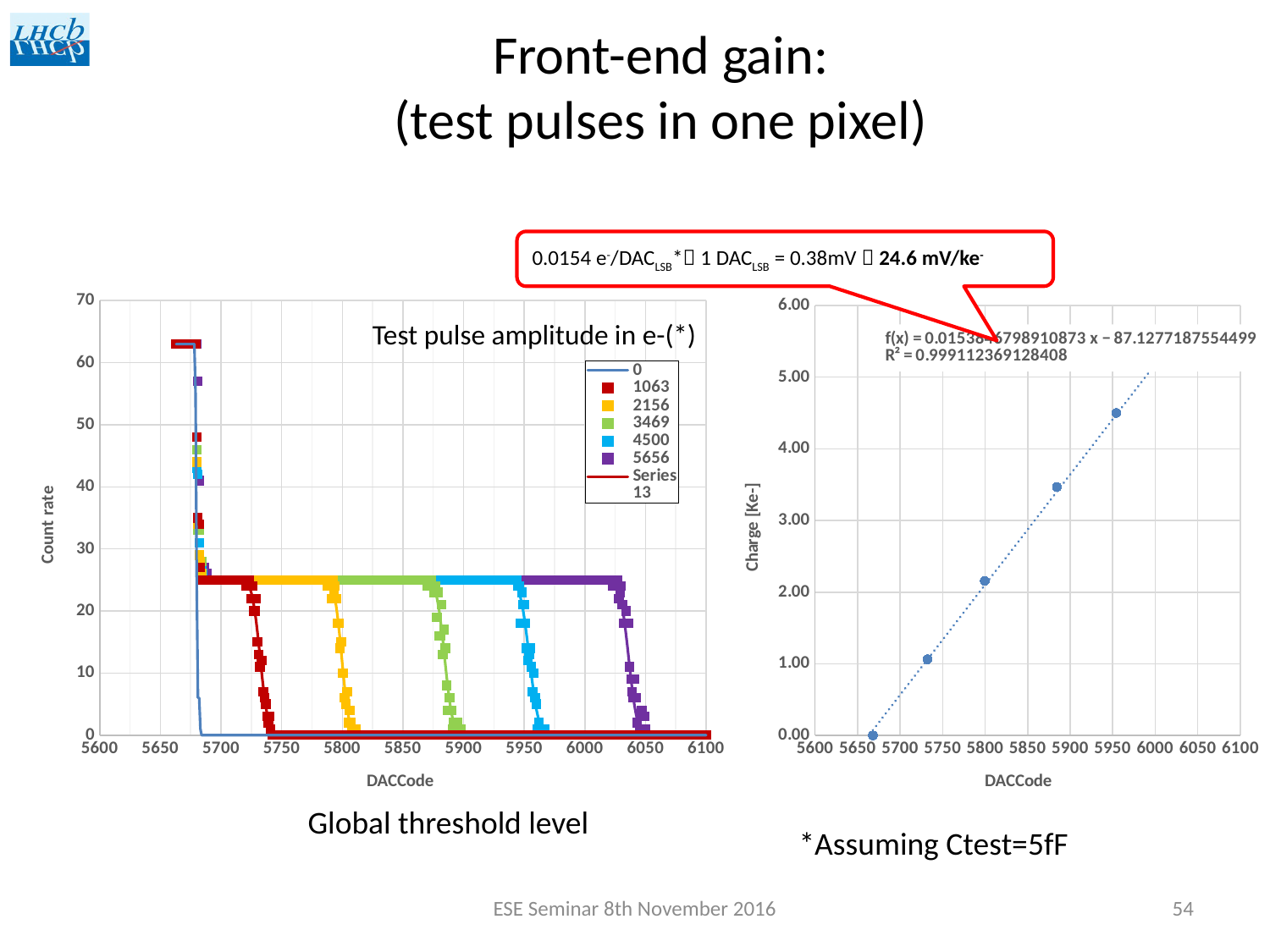
On the left chart, how many entries does the legend list? 7 On the left chart, is the plateau count rate for the 4500 series greater or less than 20? greater On the right chart, is the charge for the point near DACCode 5950 greater or less than 4.00? greater On the right chart, what is the label of the y axis? Charge [ke-] On the right chart, how many data points are plotted? 5 On the left chart, what is the label of the y axis? Count rate On the left chart, which series drops to zero at the highest DACCode: 1063 or 5656? 5656 On the left chart, is the plateau count rate for the 1063 series greater or less than 30? less On the right chart, what R² value is printed for the fitted line? 0.999112369128408 On the right chart, does the charge rise or fall as DACCode increases? rise On the left chart, what is the label of the x axis? DACCode